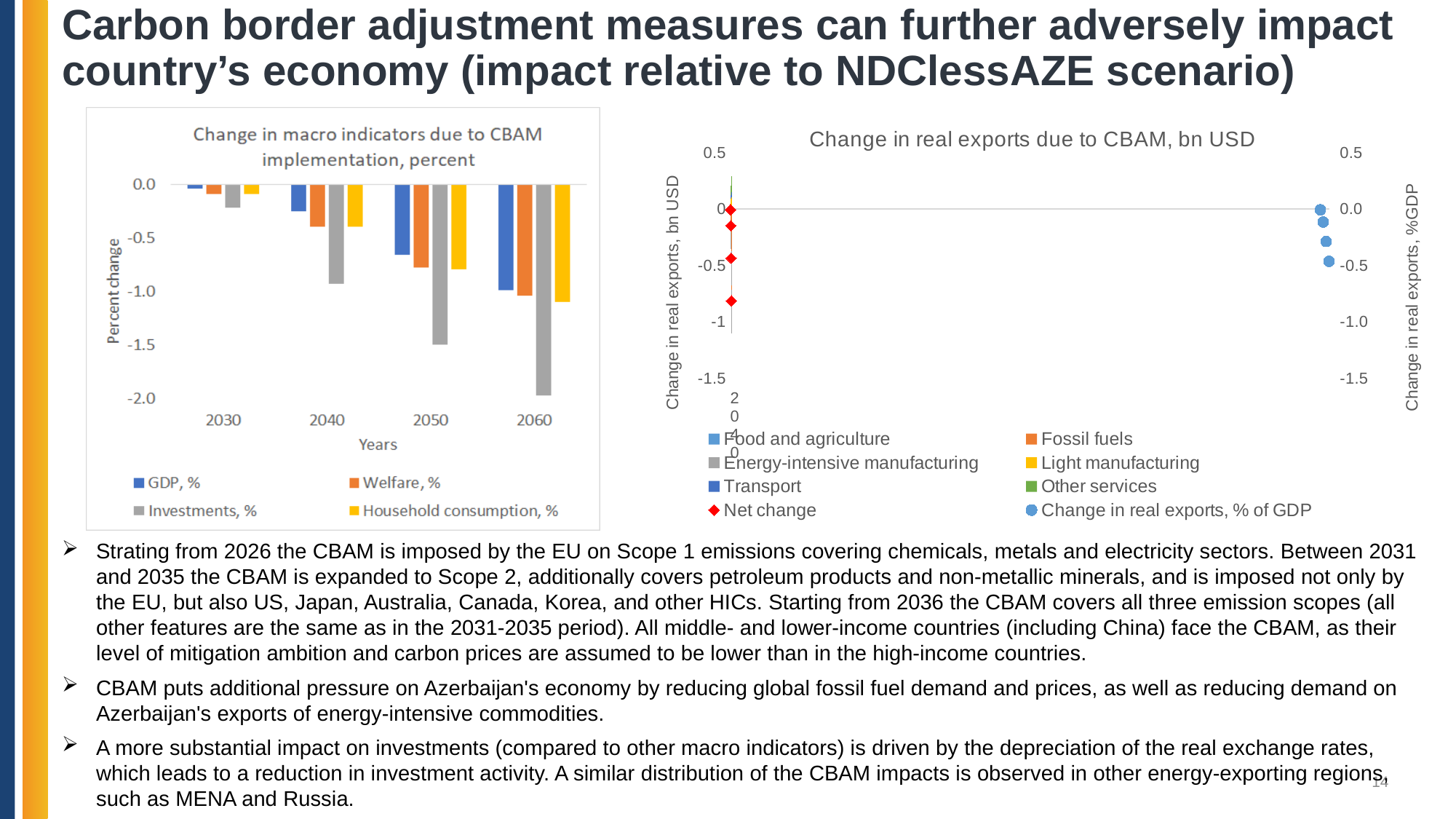
In the left chart (Change in macro indicators due to CBAM implementation), what is the label of the y axis? Percent change In the left chart (Change in macro indicators due to CBAM implementation), how many years are shown on the x axis? 4 In the right chart (Change in real exports due to CBAM, bn USD), how many entries does the legend list? 8 In the left chart (Change in macro indicators due to CBAM implementation), is the value for Welfare in 2040 greater or less than -0.5? greater In the left chart (Change in macro indicators due to CBAM implementation), which is lower in 2050: GDP or Investments? Investments, % In the left chart (Change in macro indicators due to CBAM implementation), is the value for Investments in 2050 greater or less than -1.0? less In the left chart (Change in macro indicators due to CBAM implementation), how many series does the legend list? 4 In the left chart (Change in macro indicators due to CBAM implementation), which series has the lowest value in 2060? Investments, % What kind of chart is the left chart titled "Change in macro indicators due to CBAM implementation, percent"? bar chart In the left chart (Change in macro indicators due to CBAM implementation), do the Investments values rise or fall from 2030 to 2060? fall In the left chart (Change in macro indicators due to CBAM implementation), is the value for Investments in 2060 greater or less than -1.5? less In the right chart (Change in real exports due to CBAM, bn USD), which legend entry is shown with a red diamond marker? Net change